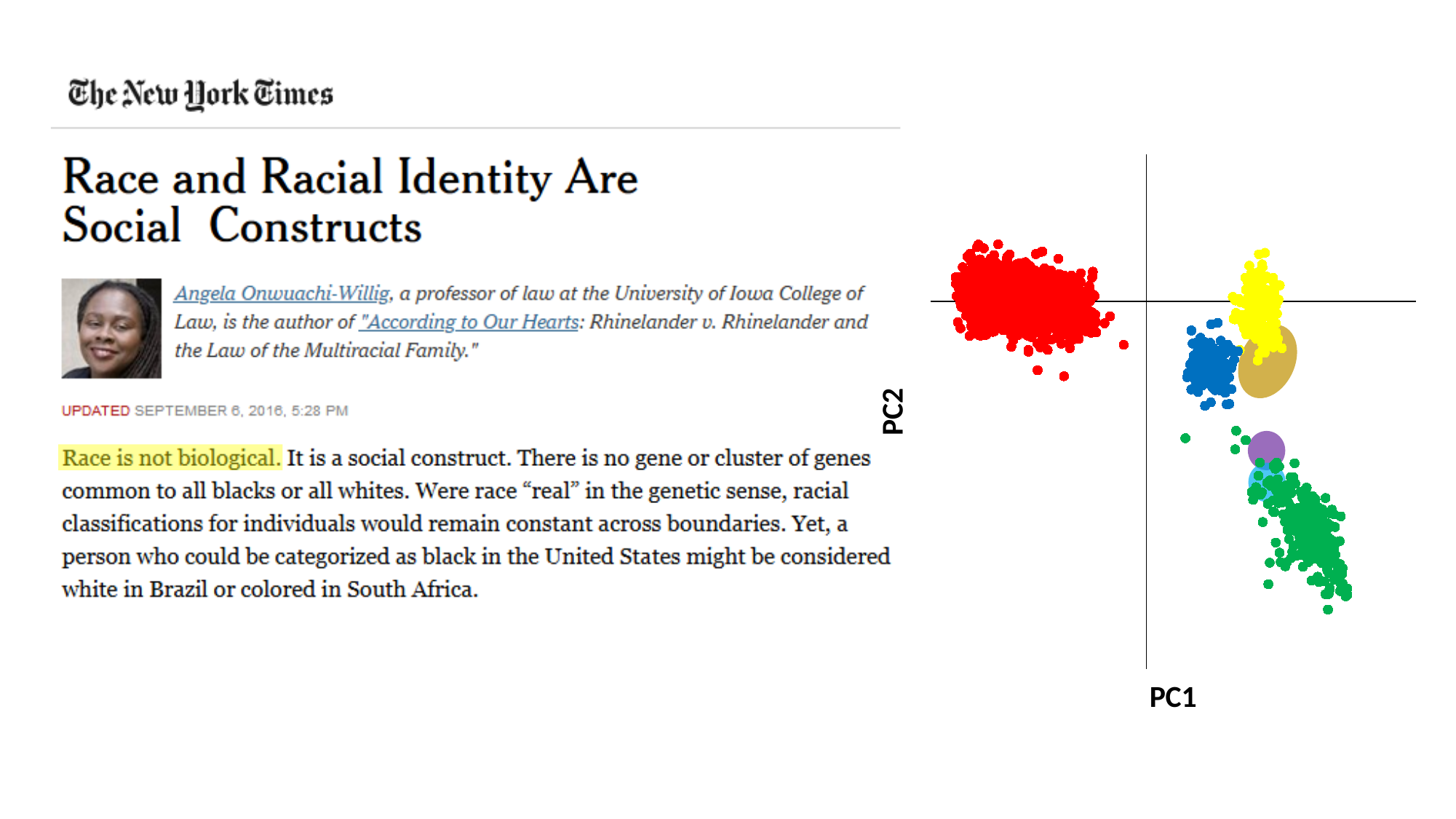
In the scatter plot, which cluster is positioned further left on PC1, the blue cluster or the yellow cluster? blue In the scatter plot, which cluster is positioned higher on PC2, the yellow cluster or the green cluster? yellow What is the label of the vertical axis of the scatter plot? PC2 Which coloured cluster in the scatter plot lies entirely to the left of the vertical axis? red What kind of chart is shown on the right side of the slide? scatter plot What is the label of the horizontal axis of the scatter plot? PC1 Which coloured cluster in the scatter plot extends lowest along the PC2 axis? green